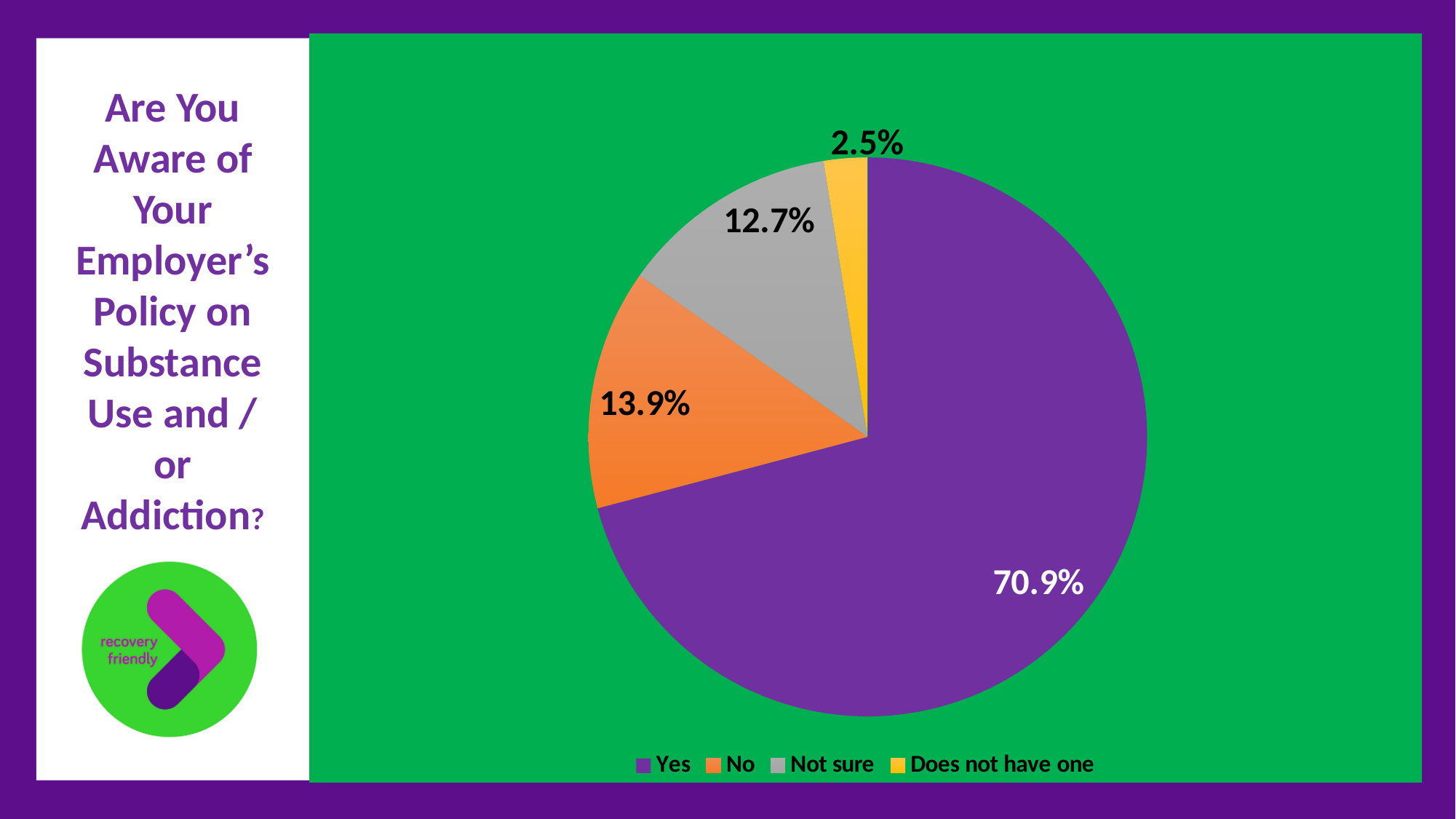
Which is larger, the "No" slice or the "Not sure" slice? No What percentage of respondents answered "Yes"? 70.9% Which response has the largest share of the pie? Yes How many entries does the legend list? 4 How many slices does the pie chart have? 4 What percentage of respondents answered "Does not have one"? 2.5% Which response has the smallest share of the pie? Does not have one What percentage of respondents answered "Not sure"? 12.7% What percentage of respondents answered "No"? 13.9% What is the difference in percentage points between the "No" and "Not sure" slices? 1.2 What colour is the "Not sure" slice? Gray What kind of chart is shown on the slide? Pie chart